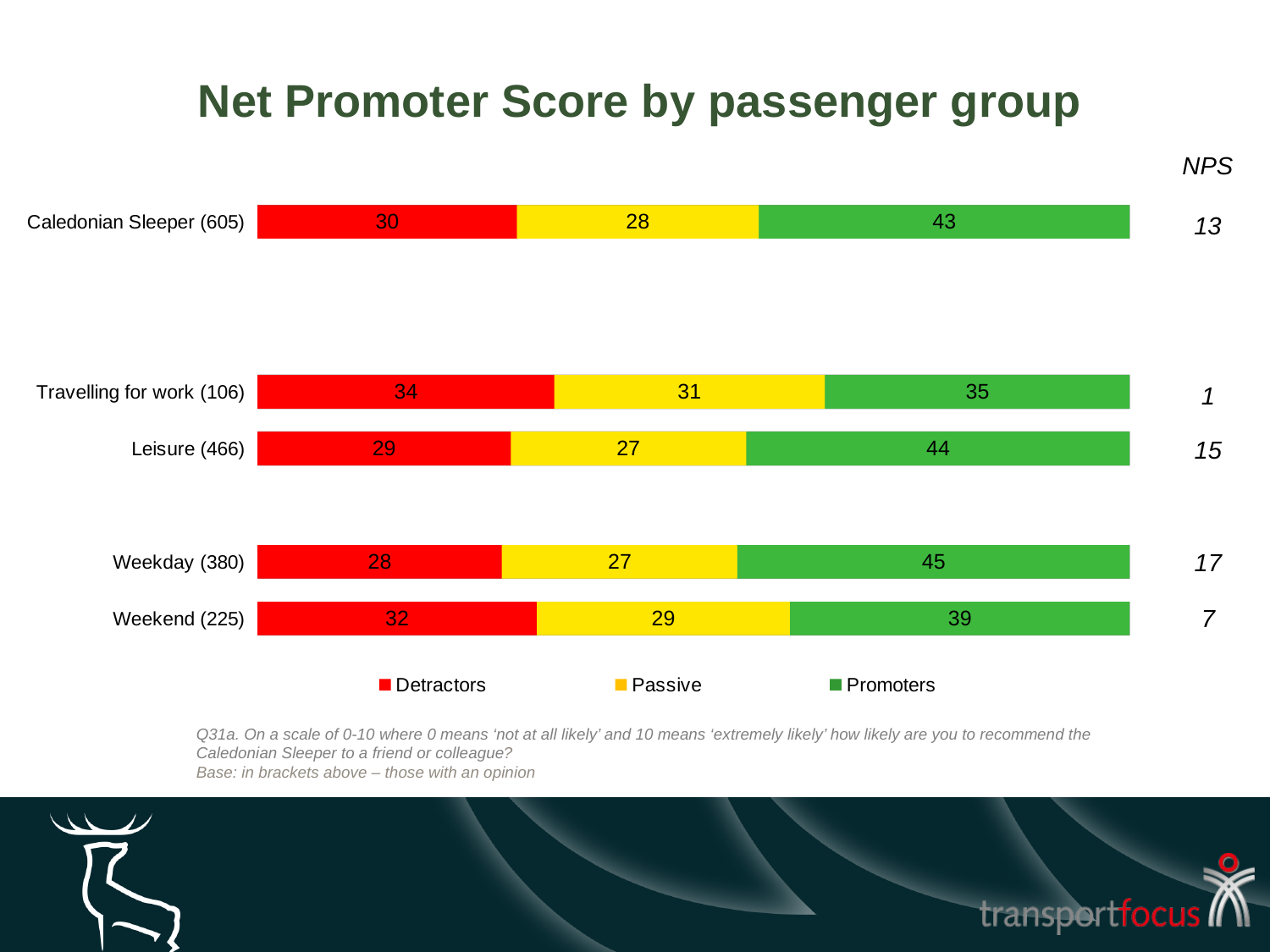
What is the Promoters value for Leisure (466)? 44 What is the Detractors value for Travelling for work (106)? 34 What is the Passive value for Weekend (225)? 29 What kind of chart is shown on the slide? Stacked bar chart How many passenger groups are shown in the chart? 5 What is the difference between the Promoters values for Weekday (380) and Weekend (225)? 6 Which colour represents Promoters in the chart? Green What is the NPS shown for Weekday (380)? 17 Which is larger, the Detractors value for Travelling for work (106) or for Leisure (466)? Travelling for work (106) Which passenger group has the lowest Detractors value? Weekday (380) How many series does the legend list? 3 Which passenger group has the highest Promoters value? Weekday (380)